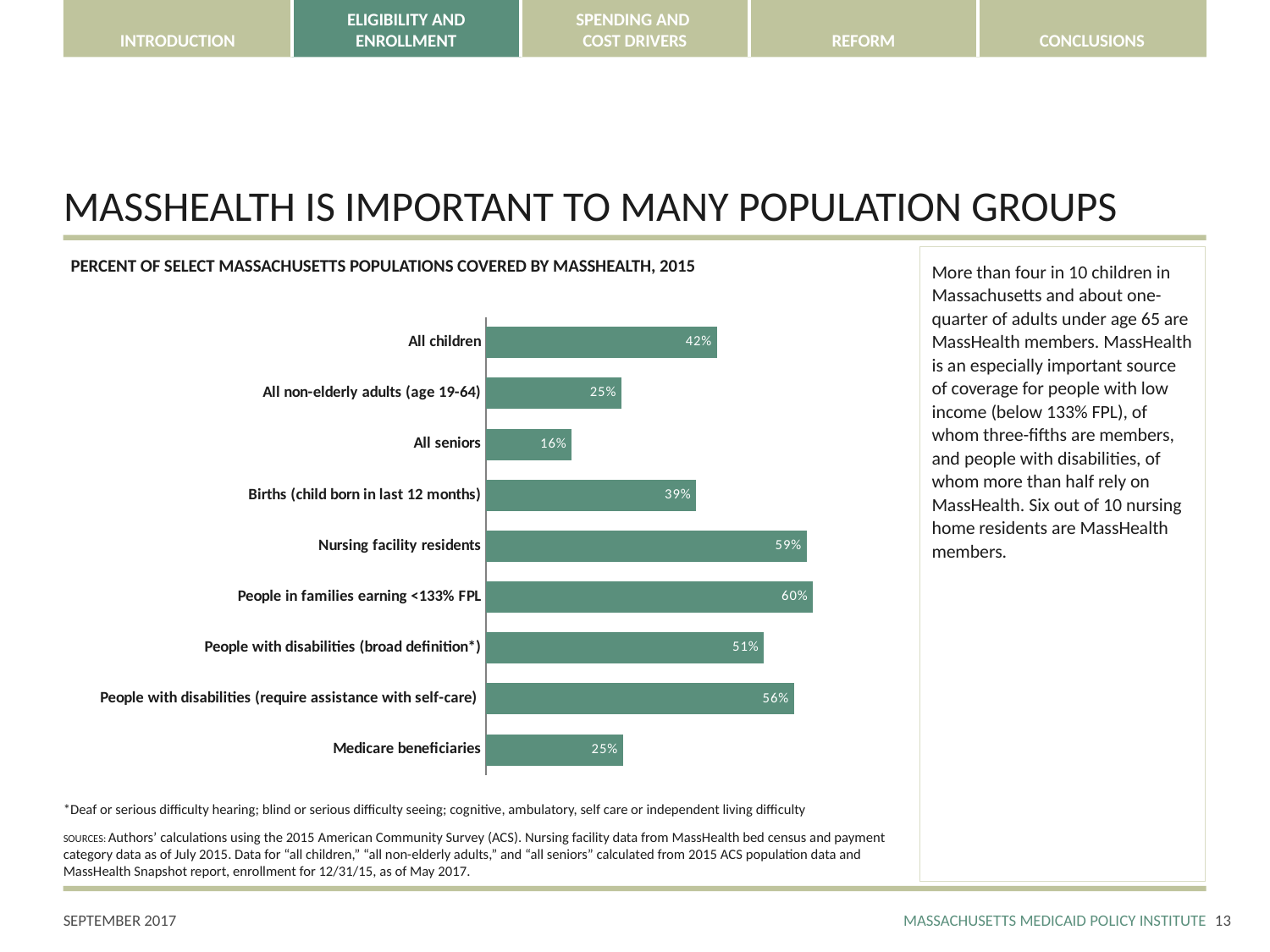
What percent of all children are covered by MassHealth? 42% What percent of all seniors are covered by MassHealth? 16% What is the value for nursing facility residents? 59% What is the difference between the value for all children and the value for all non-elderly adults (age 19-64)? 17 percentage points Which population group has the lowest percentage covered by MassHealth? All seniors What is the value for people with disabilities (require assistance with self-care)? 56% What is the difference between the value for people with disabilities (require assistance with self-care) and people with disabilities (broad definition*)? 5 percentage points What kind of chart is shown on the slide? Bar chart What is the title of the chart? Percent of select Massachusetts populations covered by MassHealth, 2015 Which is larger: the value for births (child born in last 12 months) or the value for Medicare beneficiaries? Births (child born in last 12 months) How many population groups are shown in the chart? 9 Which population group has the highest percentage covered by MassHealth? People in families earning <133% FPL